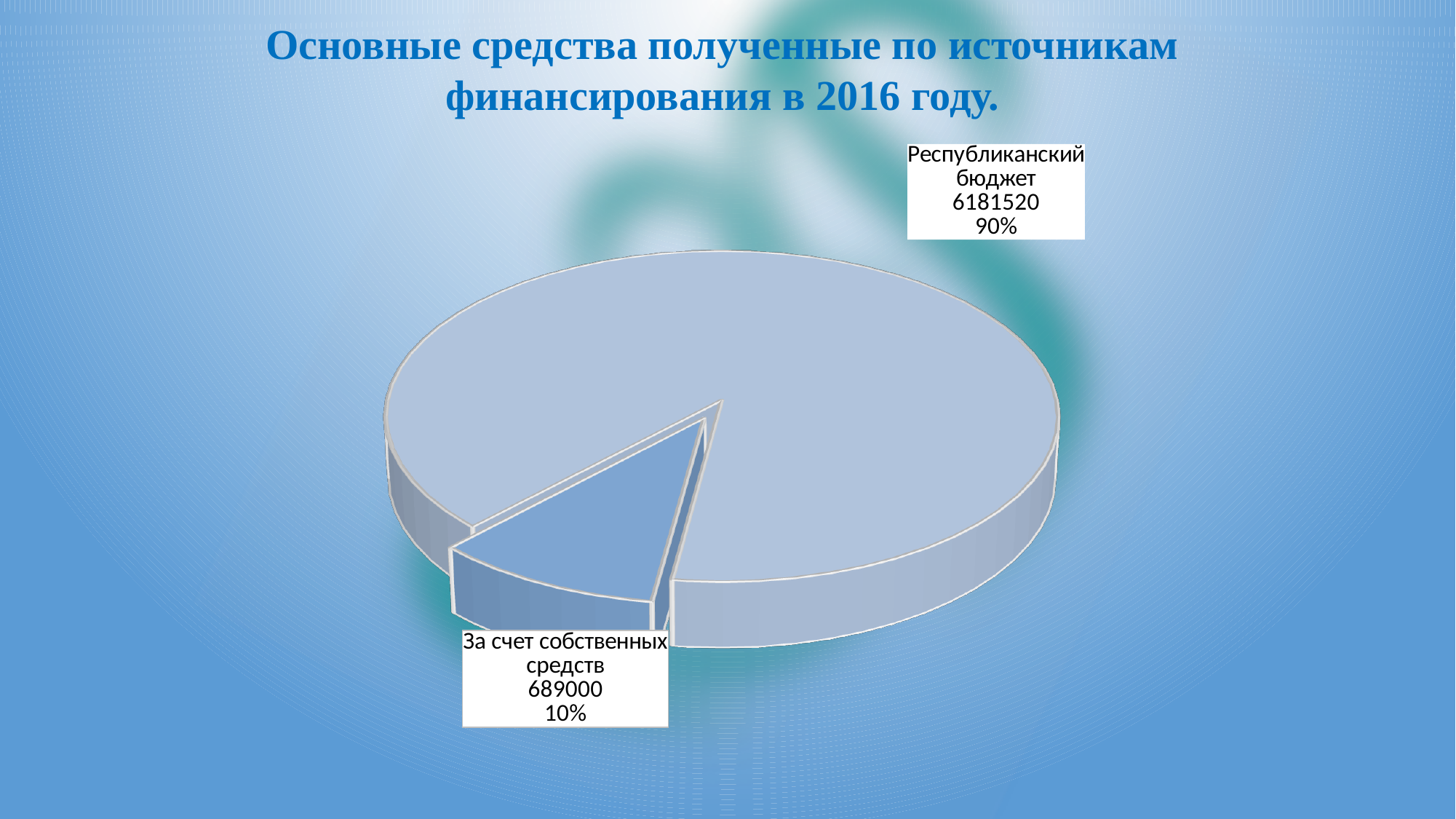
What is the value for Республиканский бюджет? 6181520 Which category has the largest slice? Республиканский бюджет What is the title of the chart? Основные средства полученные по источникам финансирования в 2016 году. Which category has the smallest slice? За счет собственных средств What is the total of the two values shown on the pie chart? 6870520 How many slices does the pie chart have? 2 What share of the pie does За счет собственных средств represent? 10% What kind of chart is shown on the slide? pie chart Which is larger, the value for Республиканский бюджет or the value for За счет собственных средств? Республиканский бюджет What is the difference between the values for Республиканский бюджет and За счет собственных средств? 5492520 What is the value for За счет собственных средств? 689000 What share of the pie does Республиканский бюджет represent? 90%